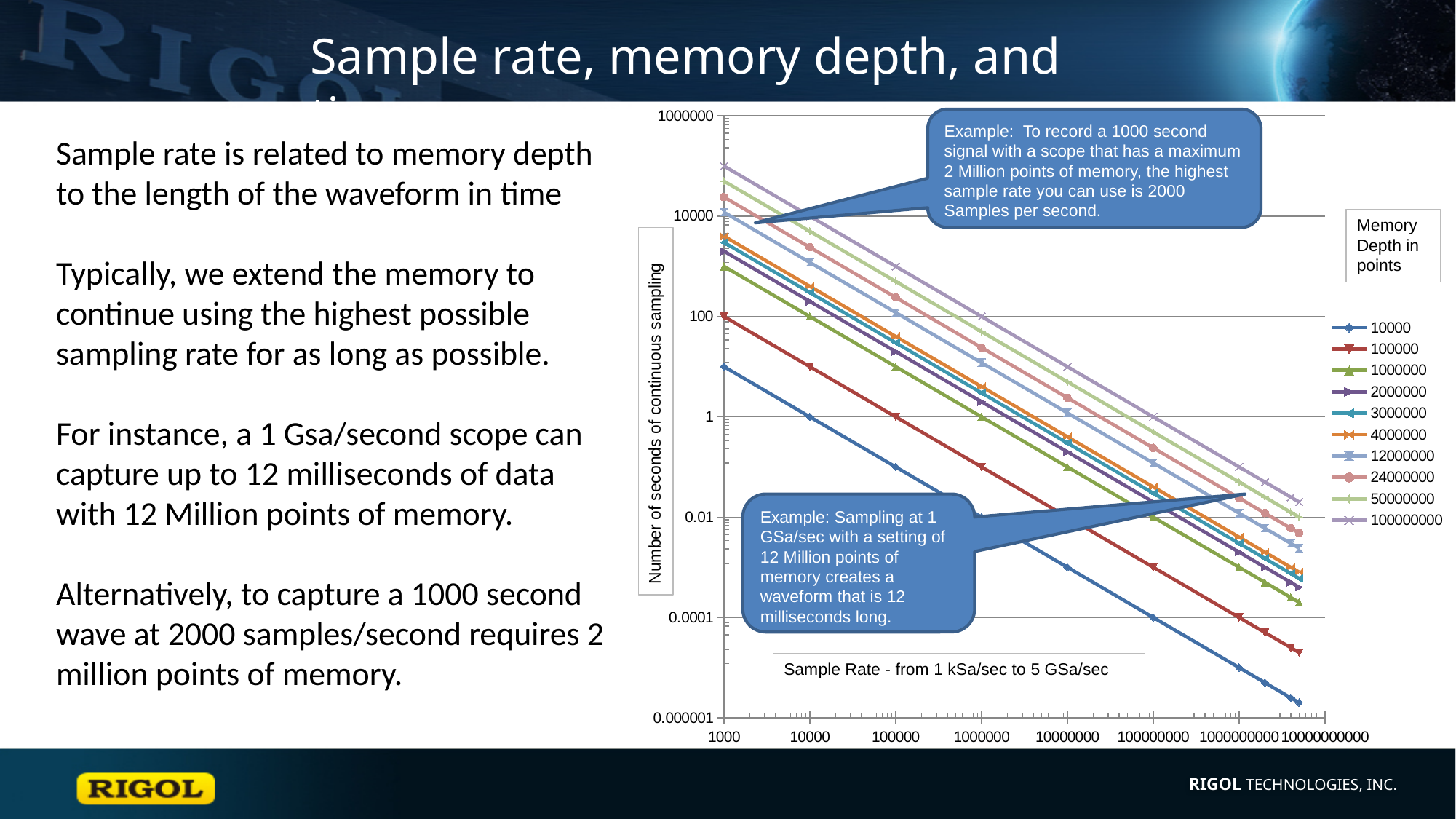
Do the plotted lines rise or fall as the sample rate increases along the x axis? fall Which memory depth series has the highest number of seconds of continuous sampling at every sample rate? 100000000 What heading is shown above the chart's legend? Memory Depth in points What kind of chart is shown on the slide? line chart Is the value for the 10000 series at a sample rate of 1000 greater or less than 1? greater Which memory depth series has the lowest number of seconds of continuous sampling at every sample rate? 10000 How many series does the chart's legend list? 10 At a sample rate of 1000, which series has the larger value: 100000000 or 10000? 100000000 What is the title of the chart's vertical axis? Number of seconds of continuous sampling How many seconds of continuous sampling does the 10000 series give at a sample rate of 100000000? 0.0001 How many seconds of continuous sampling does the 100000000 series give at a sample rate of 1000000? 100 How many seconds of continuous sampling does the 100000 series give at a sample rate of 100000? 1